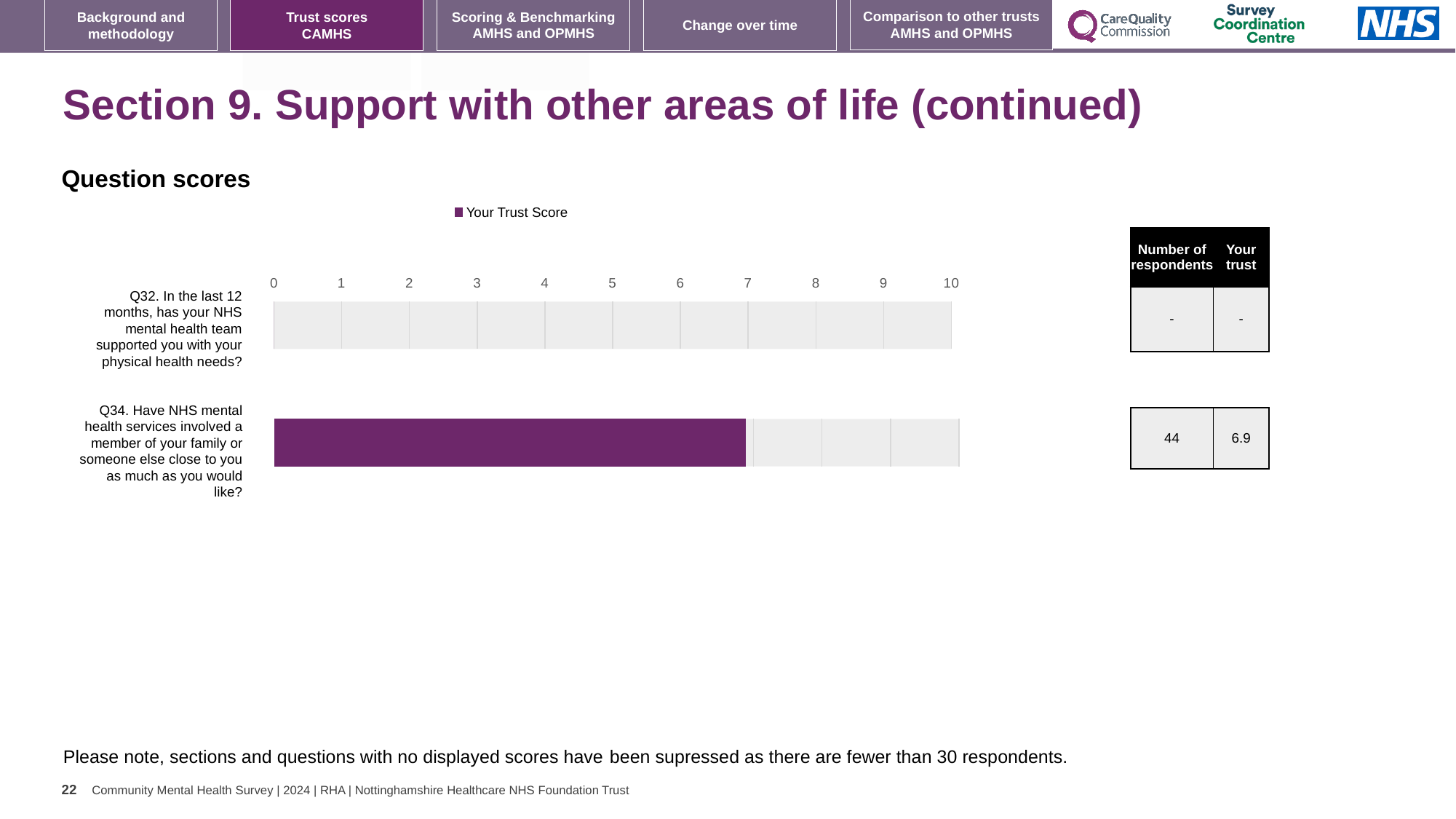
How many series does the legend list? 1 What is the maximum value shown on the chart's axis? 10 What is shown in the table for the number of respondents for Q32? - Is the trust score for Q34 greater or less than 5? greater Is the trust score for Q34 greater or less than 8? less What is the trust score for Q34 (involving a family member or someone close as much as you would like)? 6.9 Which question has a displayed trust score, Q32 or Q34? Q34 How many questions are listed on the chart? 2 What is the name of the series shown in the legend? Your Trust Score How many respondents answered Q34? 44 What kind of chart is shown on the slide? bar chart